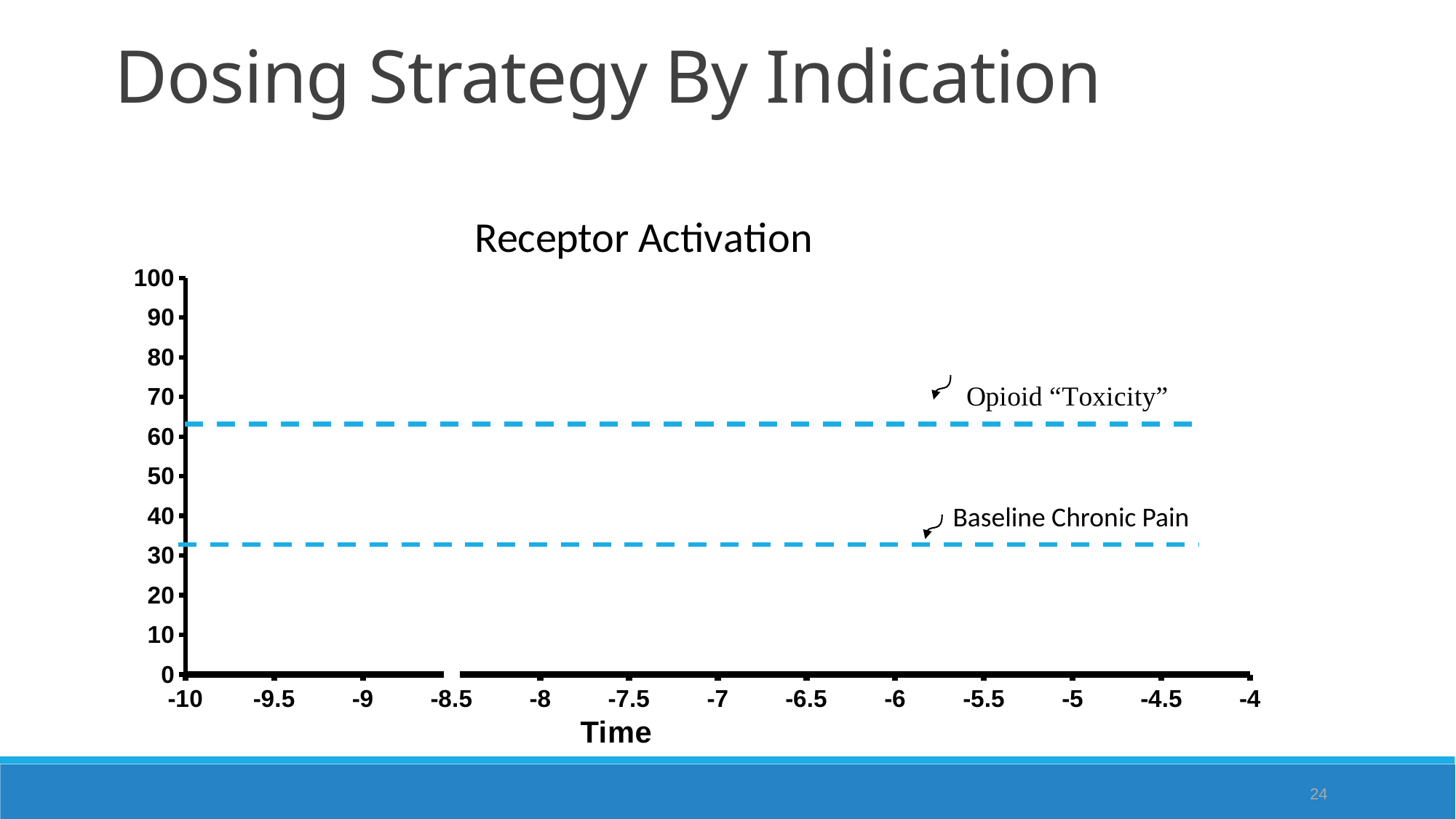
What is the title of the chart on the slide? Receptor Activation Do the values of the Baseline Chronic Pain line rise, fall, or stay constant along the x axis? stay constant What kind of chart is shown on the slide? line chart What is the label of the x axis? Time What is the highest value shown on the y axis? 100 Which line is higher on the chart, Opioid "Toxicity" or Baseline Chronic Pain? Opioid "Toxicity" How many tick labels are shown on the x axis? 13 Is the value of the Baseline Chronic Pain line greater or less than 40? less Is the value of the Opioid "Toxicity" line greater or less than 60? greater Is the value of the Opioid "Toxicity" line greater or less than 70? less How many dashed lines are plotted on the chart? 2